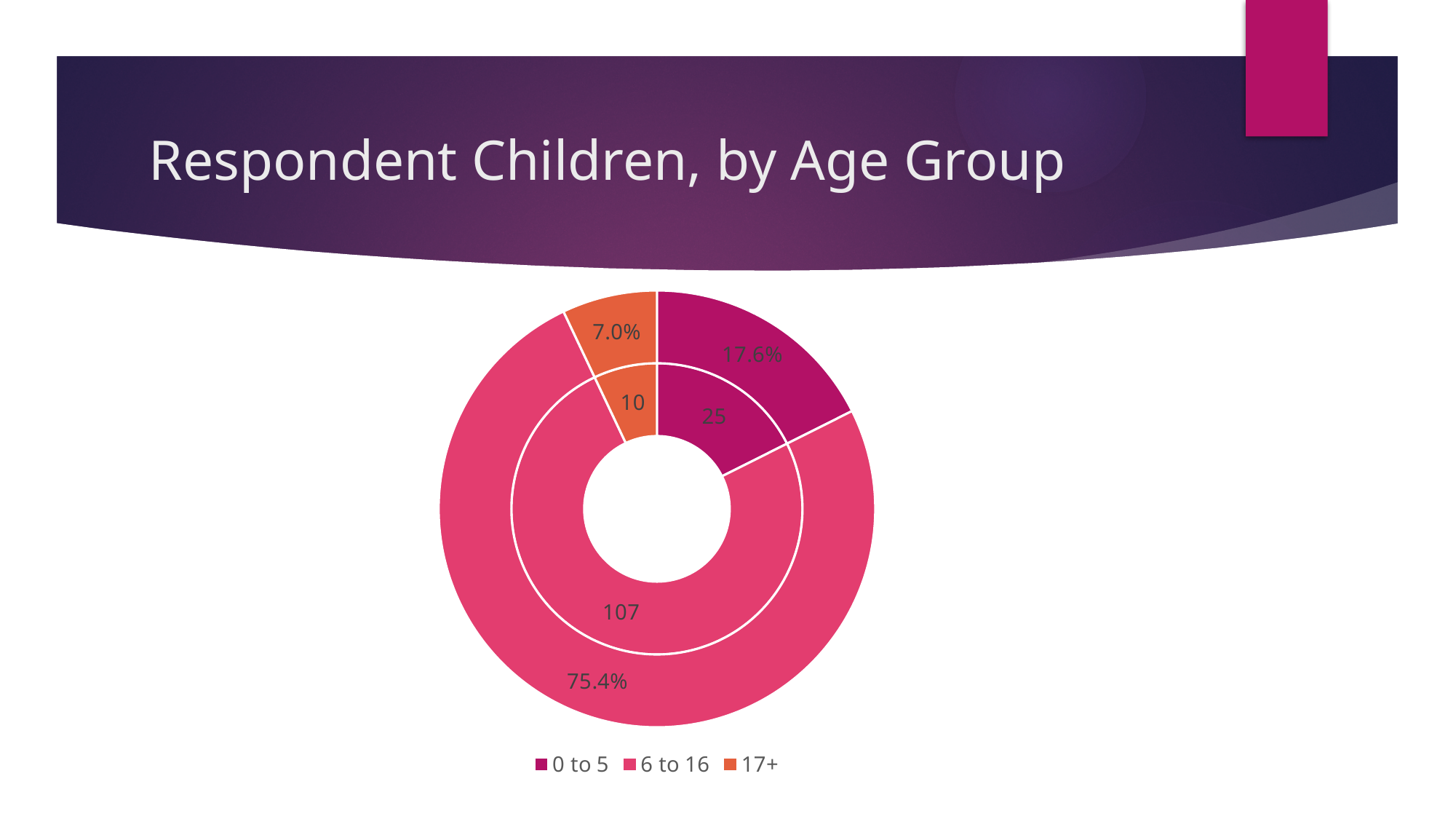
How many age groups does the legend list? 3 Which age group has the smallest share of respondent children? 17+ What percentage is shown for the 0 to 5 age group in the outer ring? 17.6% What is the count for the 0 to 5 age group in the inner ring? 25 What is the title of the slide? Respondent Children, by Age Group What is the count for the 6 to 16 age group in the inner ring? 107 What is the count for the 17+ age group in the inner ring? 10 How many more children are in the 6 to 16 group than in the 0 to 5 group? 82 Which age group has the largest share of respondent children? 6 to 16 What percentage is shown for the 6 to 16 age group in the outer ring? 75.4% What kind of chart is shown on the slide? Doughnut chart What percentage is shown for the 17+ age group in the outer ring? 7.0%